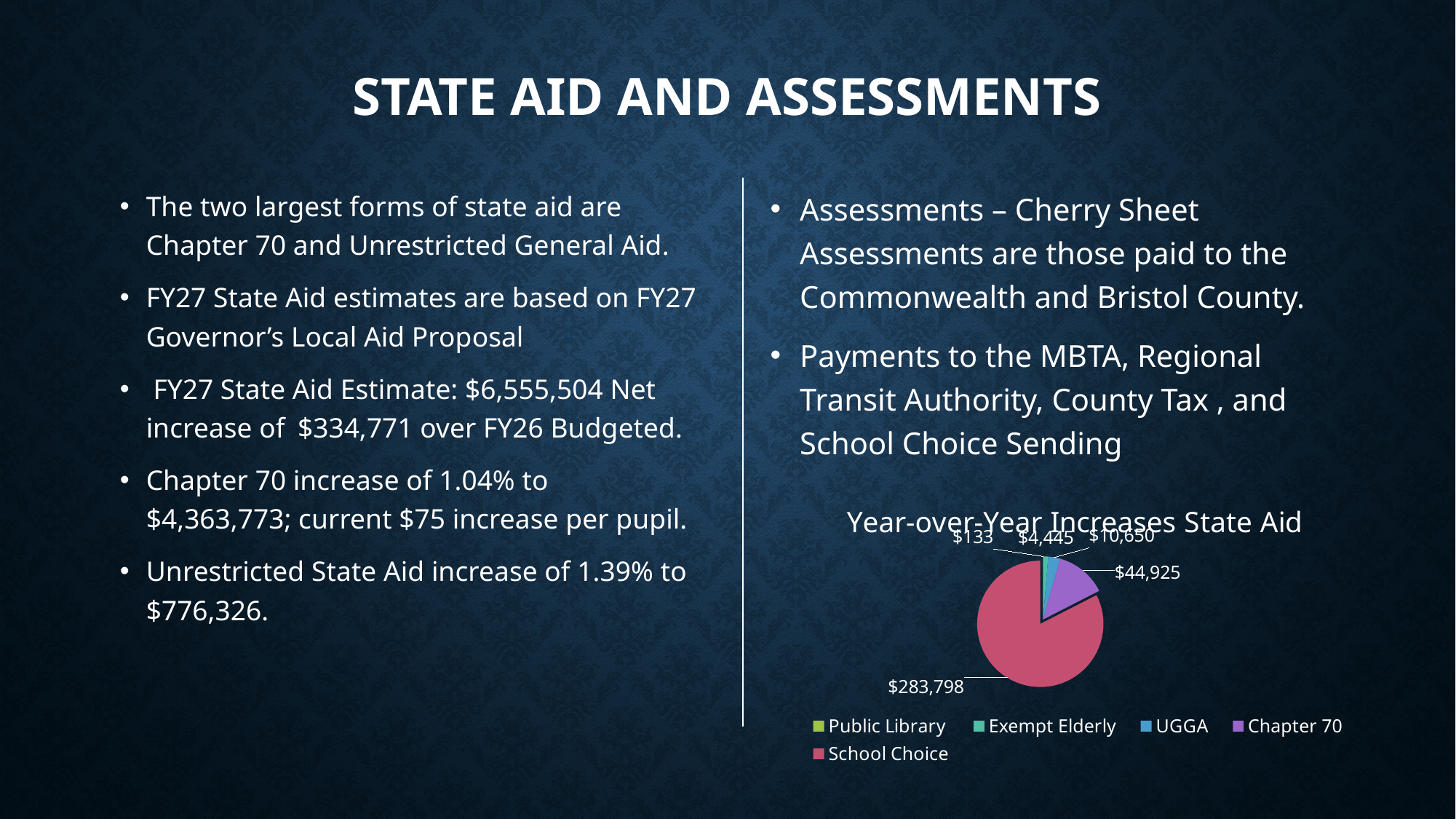
What is the value shown for School Choice in the pie chart? $283,798 What is the value shown for UGGA in the pie chart? $10,650 What colour is the School Choice slice in the pie chart? Red What is the difference between the School Choice value and the Chapter 70 value in the pie chart? $238,873 What kind of chart is shown on the slide? Pie chart Which category has the largest slice in the pie chart? School Choice What is the title of the chart on the slide? Year-over-Year Increases State Aid What is the value shown for Exempt Elderly in the pie chart? $4,445 Which is larger in the pie chart, Chapter 70 or UGGA? Chapter 70 How many categories does the legend of the pie chart list? 5 Which category has the smallest value in the pie chart? Public Library What is the value shown for Chapter 70 in the pie chart? $44,925